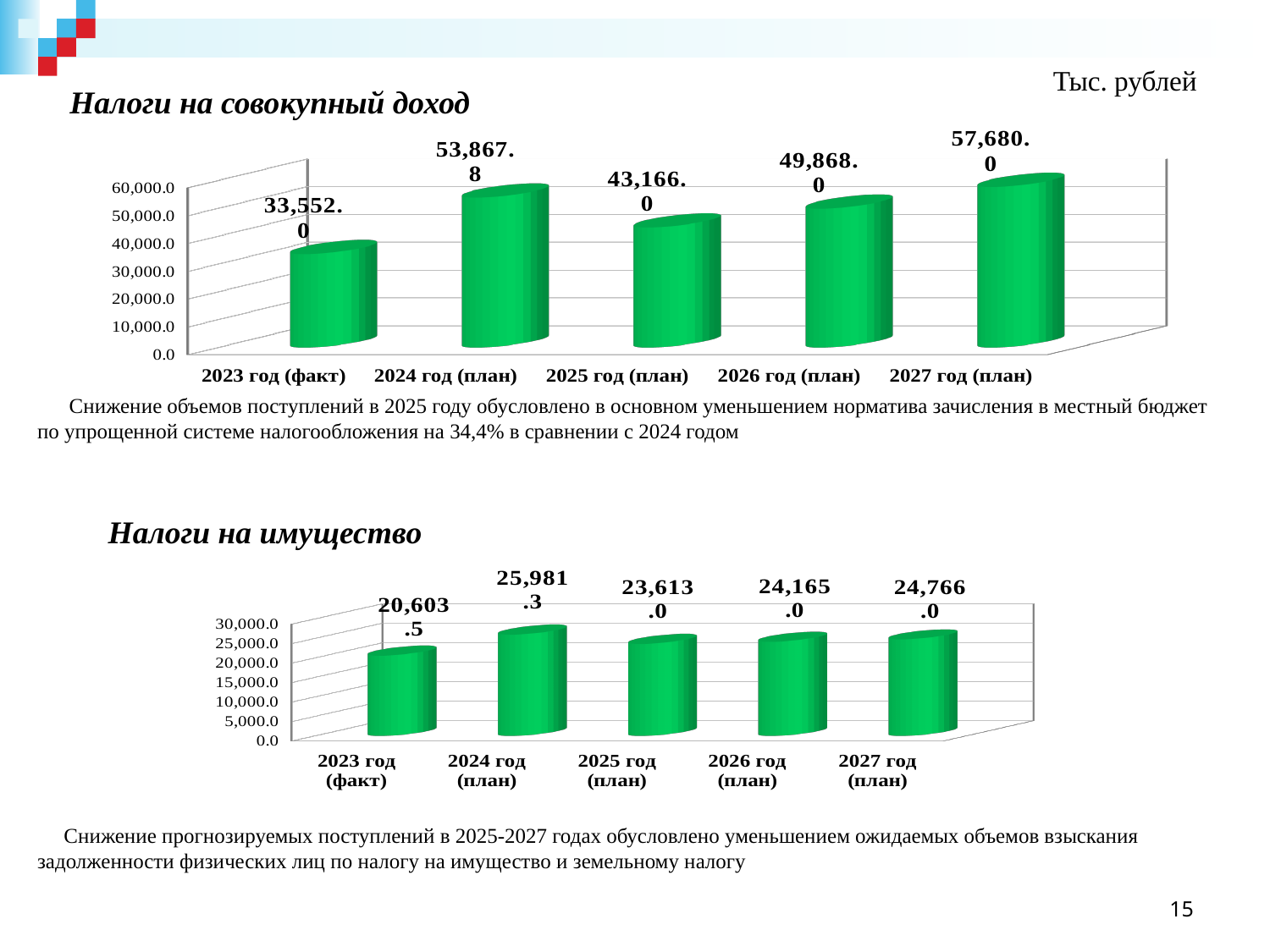
In the chart 'Налоги на совокупный доход', which year has the highest value? 2027 год (план) In the chart 'Налоги на имущество', what is the difference between the values for 2024 год (план) and 2023 год (факт)? 5,377.8 In the chart 'Налоги на совокупный доход', how many bars are plotted? 5 In the chart 'Налоги на совокупный доход', what is the value for 2024 год (план)? 53,867.8 In the chart 'Налоги на совокупный доход', which year has the lowest value? 2023 год (факт) What type of chart is 'Налоги на имущество'? Bar chart In the chart 'Налоги на имущество', which is larger, the value for 2025 год (план) or 2027 год (план)? 2027 год (план) In the chart 'Налоги на имущество', which year has the highest value? 2024 год (план) In the chart 'Налоги на имущество', what is the value for 2023 год (факт)? 20,603.5 In the chart 'Налоги на совокупный доход', what is the difference between the values for 2024 год (план) and 2025 год (план)? 10,701.8 In the chart 'Налоги на имущество', do the values rise or fall from 2025 год (план) to 2027 год (план)? Rise In the chart 'Налоги на совокупный доход', is the value for 2026 год (план) greater or less than 40,000.0? greater